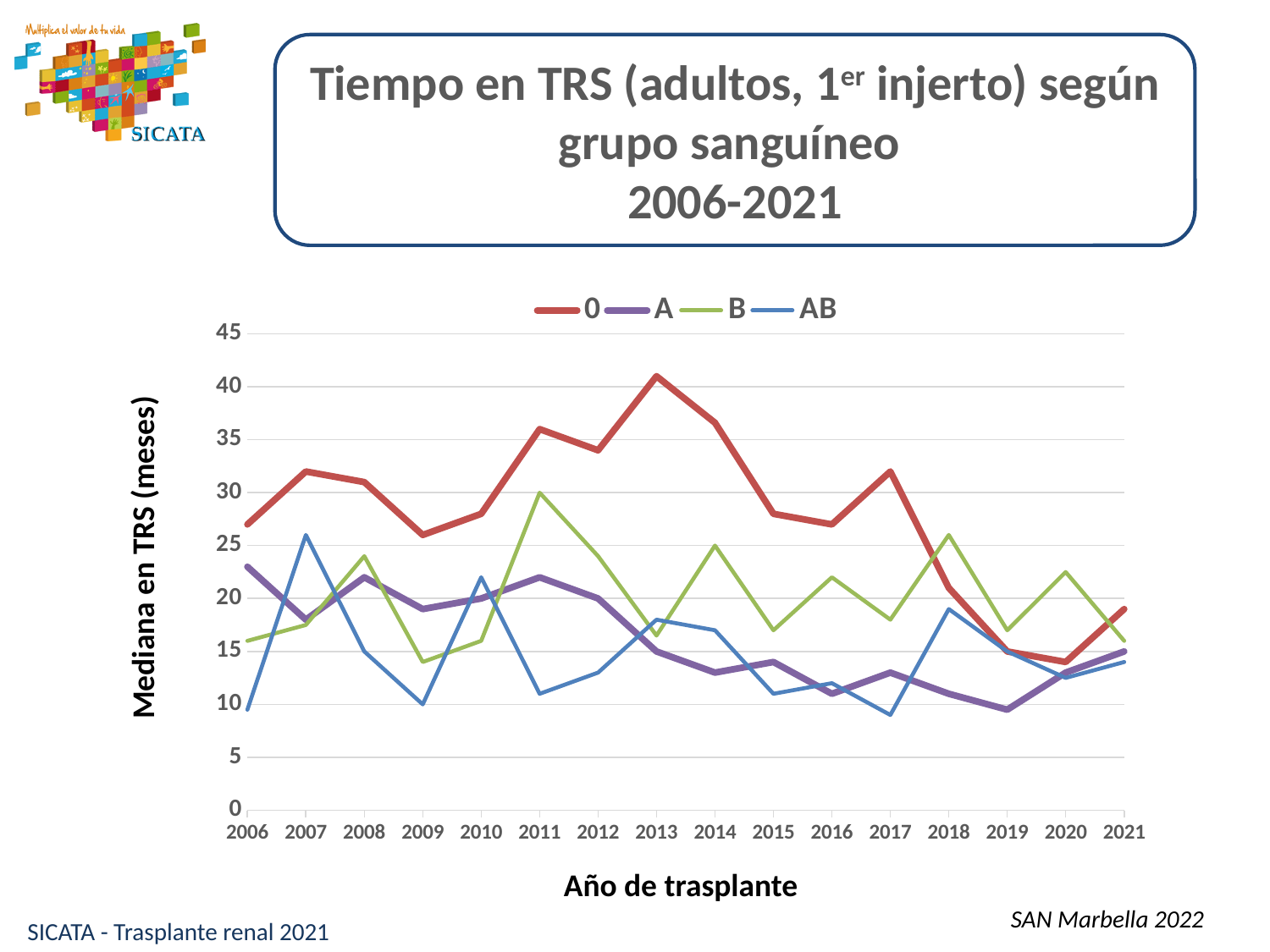
What kind of chart is shown on the slide? line chart How many series does the legend list? 4 Which series has the highest value in 2013? 0 In which year does series 0 reach its highest value? 2013 Is the value for series 0 in 2013 greater or less than 40? greater What is the label of the y axis? Mediana en TRS (meses) Which series has the lowest value in 2017? AB How many years are plotted along the x axis? 16 Does the value for series 0 rise or fall from 2017 to 2019? fall Is the value for series B in 2018 greater or less than 25? greater In 2007, which is larger: the value for series 0 or the value for series AB? 0